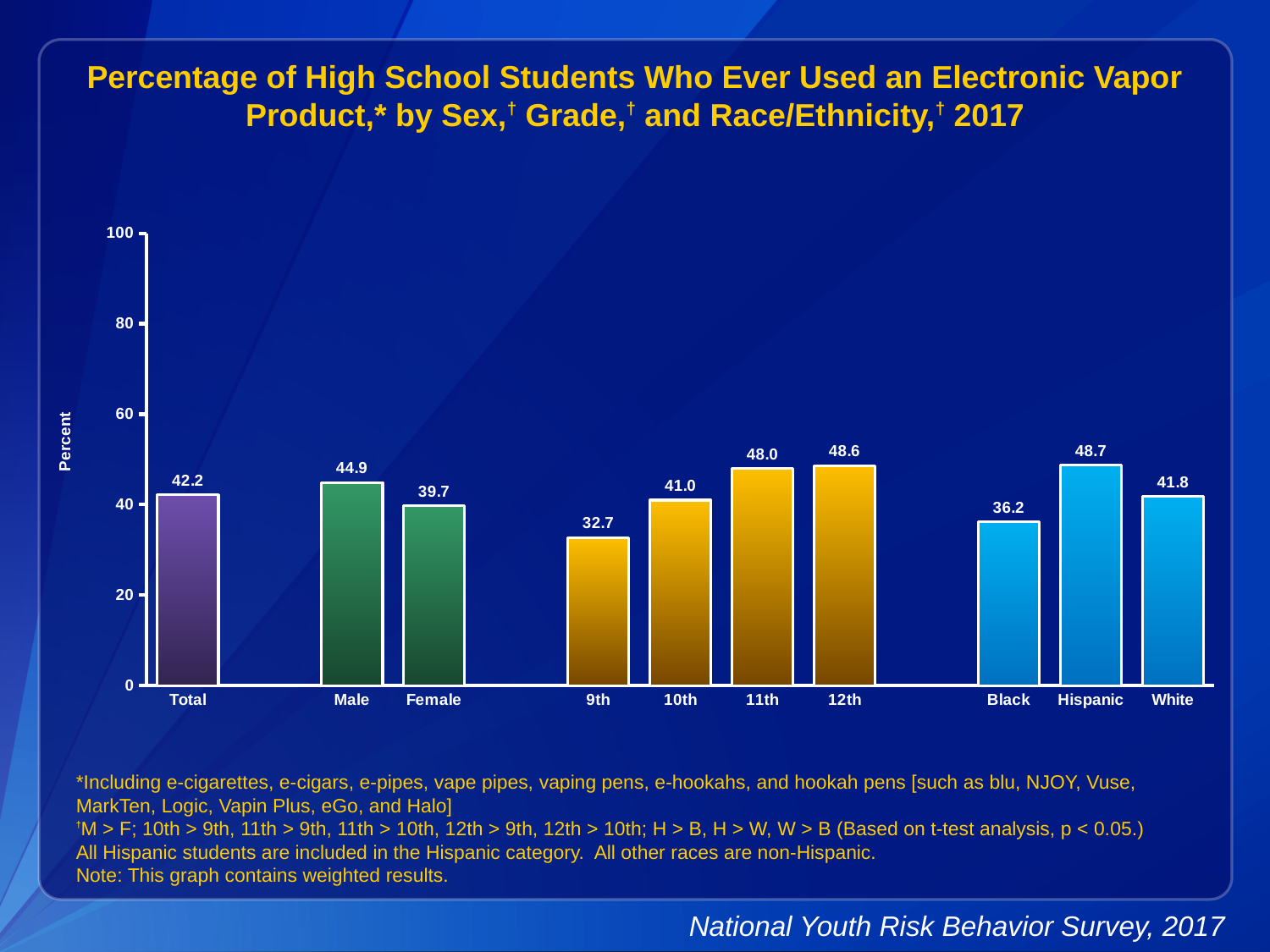
What kind of chart is this? bar chart What is the difference between the values for Male and Female? 5.2 What is the value for 9th grade? 32.7 Is the value for 11th grade greater or less than 40? greater What is the value for Hispanic students? 48.7 Which is larger, the value for Black or the value for White? White What is the value for Total? 42.2 How many categories are shown on the x axis? 10 What is the label on the y axis? Percent Which category has the highest value? Hispanic Do the values rise or fall from 9th grade to 12th grade? rise Which category has the lowest value? 9th